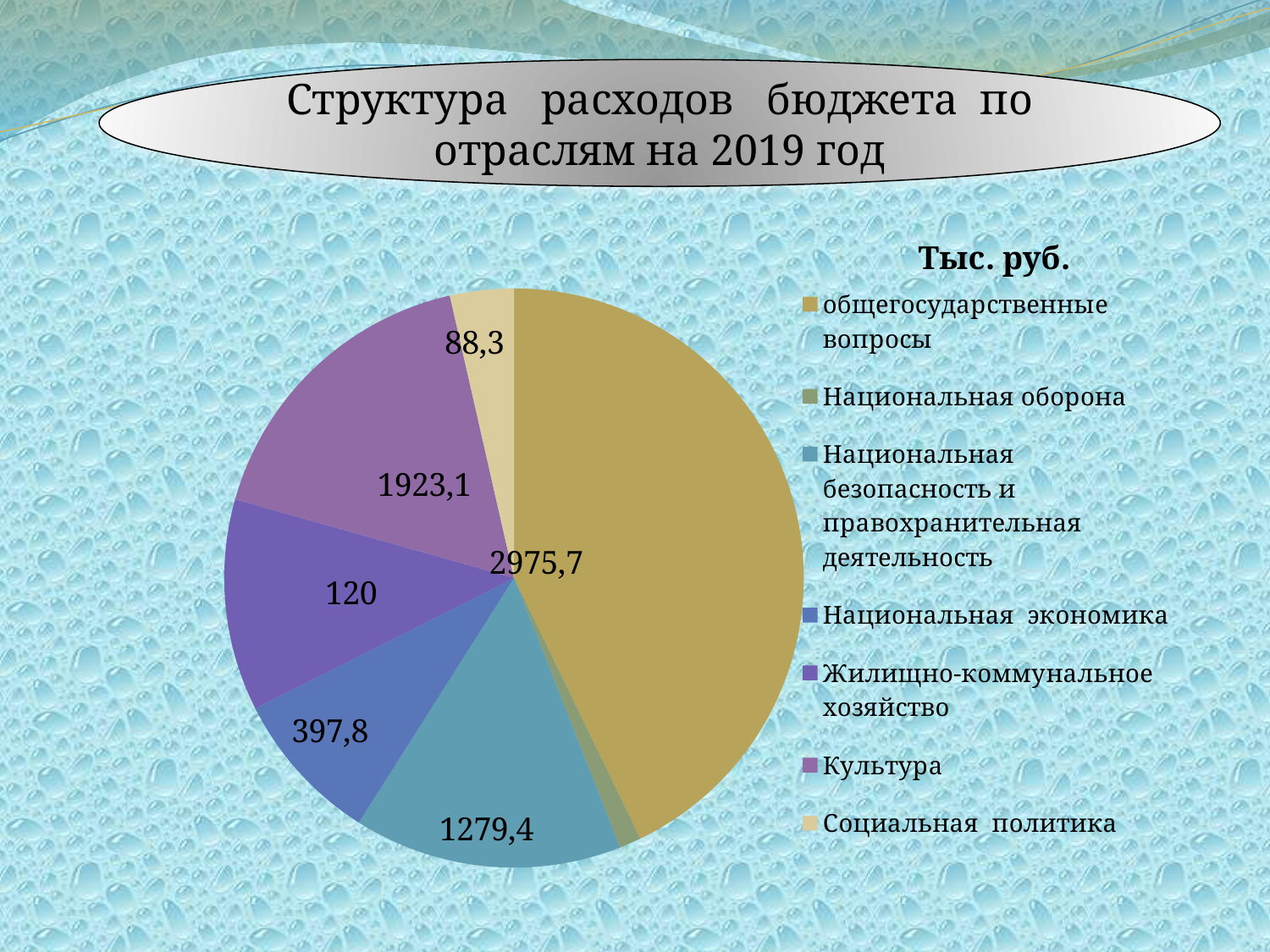
Which is larger, общегосударственные вопросы or Культура? общегосударственные вопросы What is the value for Национальная экономика? 397,8 Which category has the largest slice of the pie? общегосударственные вопросы What is the value for Национальная безопасность и правохранительная деятельность? 1279,4 What is the value for Культура? 1923,1 What is the value for Социальная политика? 88,3 What is the value for Жилищно-коммунальное хозяйство? 120 What kind of chart is shown on the slide? pie chart What is the value for общегосударственные вопросы? 2975,7 In what unit are the values of the chart given, according to the label above the legend? Тыс. руб. What is the difference between общегосударственные вопросы and Культура? 1052,6 How many categories does the legend of the pie chart list? 7